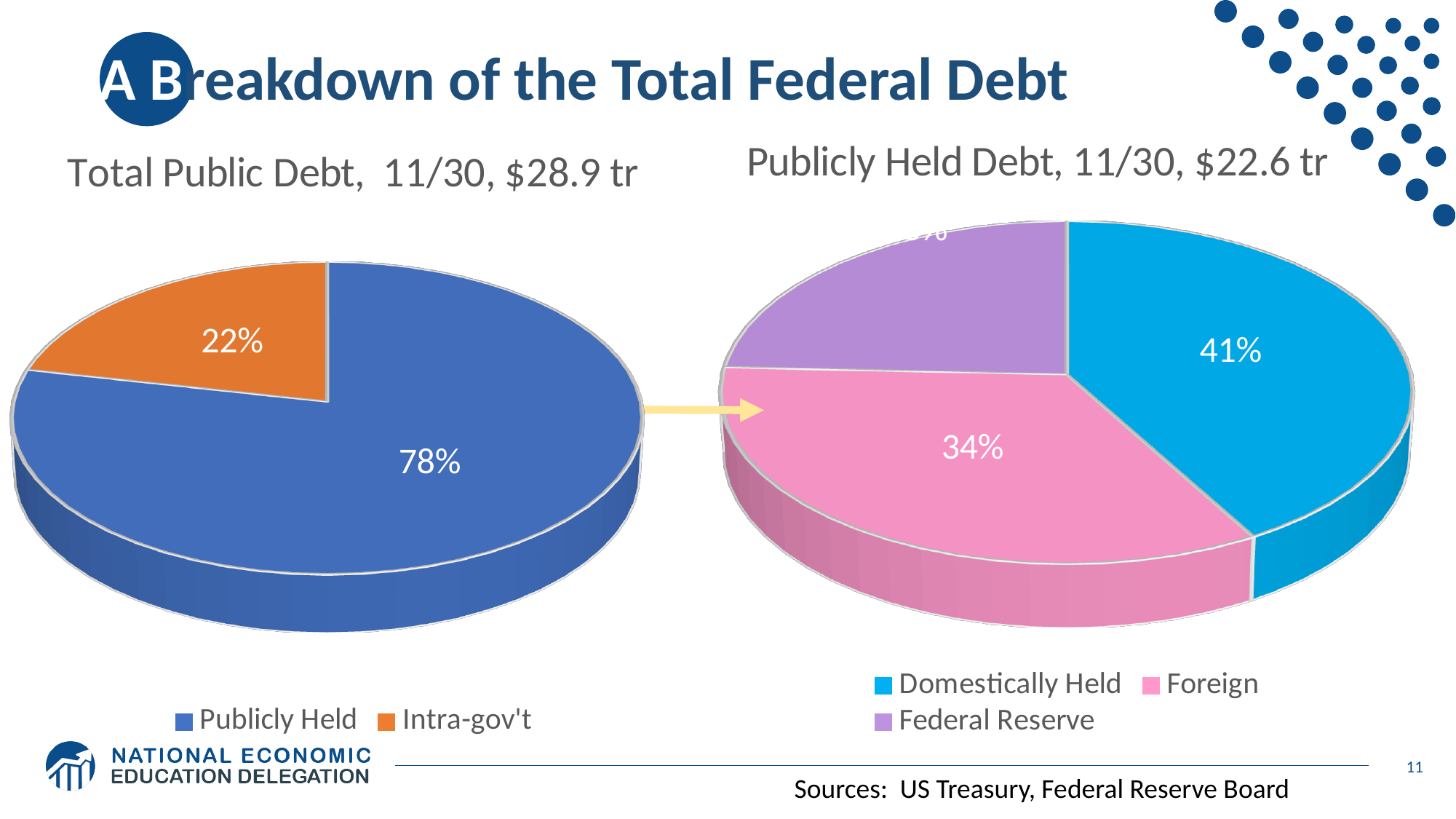
In the Publicly Held Debt pie chart, what share is Domestically Held? 41% In the Total Public Debt pie chart, how many percentage points larger is the Publicly Held share than the Intra-gov't share? 56 percentage points What total amount is given in the title of the right-hand chart, Publicly Held Debt? $22.6 tr How many categories does the Publicly Held Debt pie chart show? 3 In the Total Public Debt pie chart, what share is Publicly Held? 78% In the Publicly Held Debt pie chart, which is larger: Domestically Held or Foreign? Domestically Held In the Publicly Held Debt pie chart, what share is Foreign? 34% In the Total Public Debt pie chart, what share is Intra-gov't? 22% In the Publicly Held Debt pie chart, which category is shown in purple according to the legend? Federal Reserve In the Publicly Held Debt pie chart, which category has the largest share? Domestically Held What type of chart is used for the Total Public Debt on the left? Pie chart In the Total Public Debt pie chart, which category has the smallest share? Intra-gov't